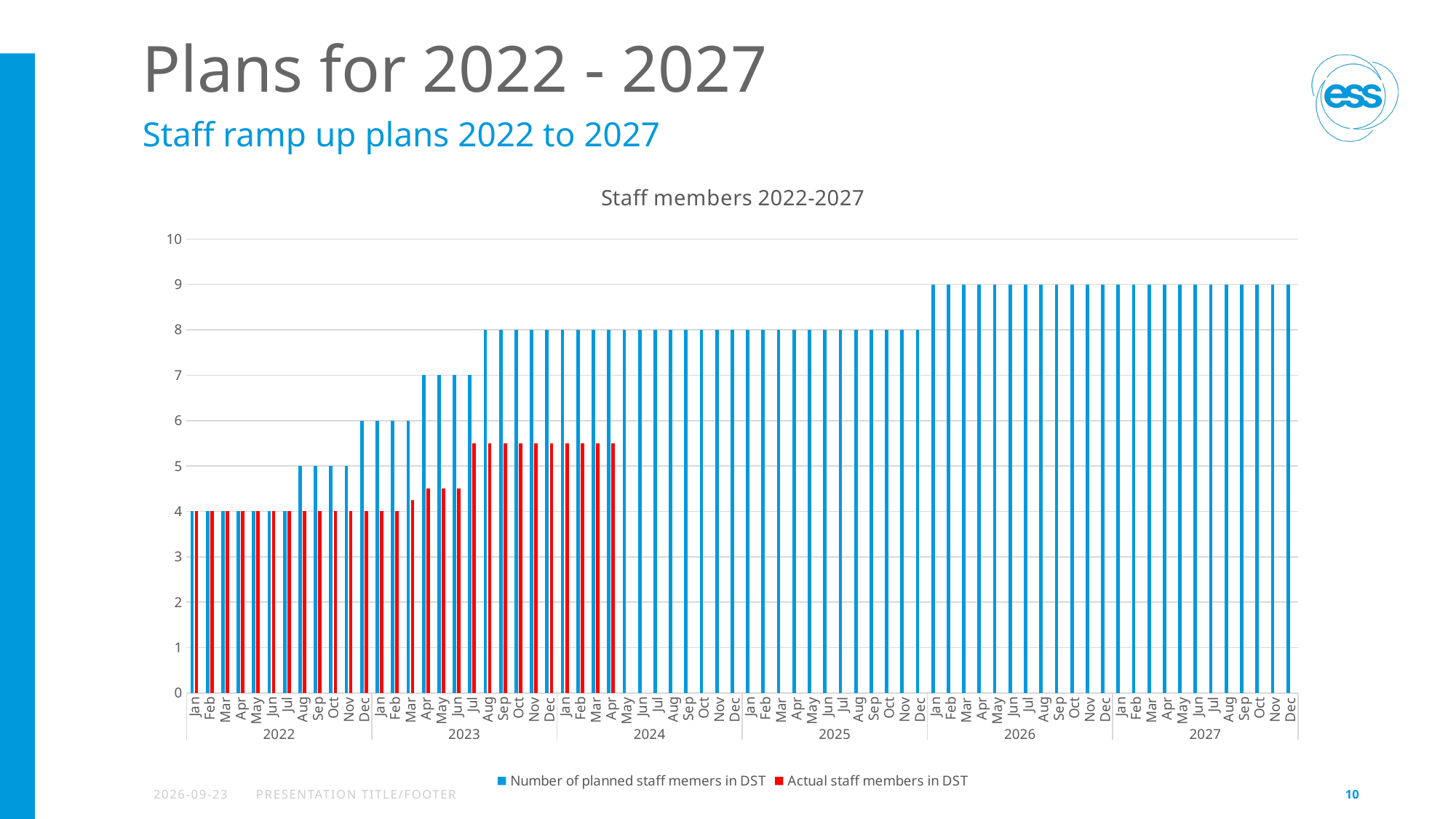
What kind of chart is shown on the slide? Bar chart What is the number of planned staff members in DST for Dec 2027? 9 What is the number of planned staff members in DST for Jan 2022? 4 What is the number of planned staff members in DST for Jun 2025? 8 In Apr 2024, which is larger: the number of planned staff members or the actual staff members? Number of planned staff members Is the actual staff members value for Apr 2024 greater or less than 5? greater What is the difference between the planned staff members in Dec 2027 and in Jan 2022? 5 How many series does the legend of the chart list? 2 What is the title of the chart? Staff members 2022-2027 What is the highest value reached by the planned staff members series? 9 What is the number of planned staff members in DST for Apr 2023? 7 What is the lowest value of the planned staff members series? 4